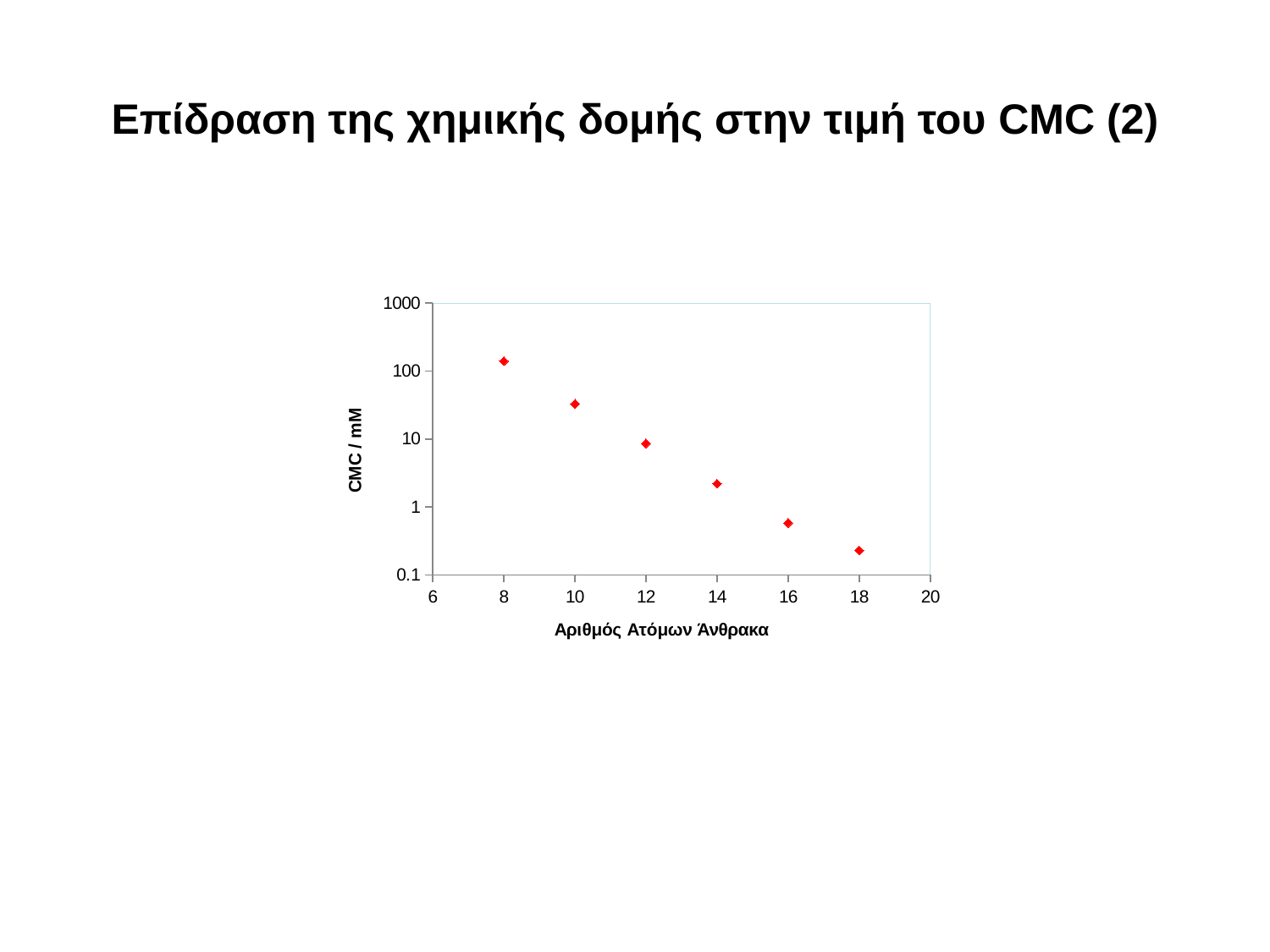
Is the CMC value for 10 carbon atoms greater or less than 10? greater Is the CMC value for 14 carbon atoms greater or less than 1? greater At which number of carbon atoms is the CMC value lowest? 18 How many data points are plotted on the chart? 6 What is the label of the y axis? CMC / mM Do the CMC values rise or fall as the number of carbon atoms increases? fall Is the CMC value for 16 carbon atoms greater or less than 1? less Which has a larger CMC value: 10 carbon atoms or 14 carbon atoms? 10 carbon atoms At which number of carbon atoms is the CMC value highest? 8 What kind of chart is shown on the slide? scatter plot What is the label of the x axis? Αριθμός Ατόμων Άνθρακα